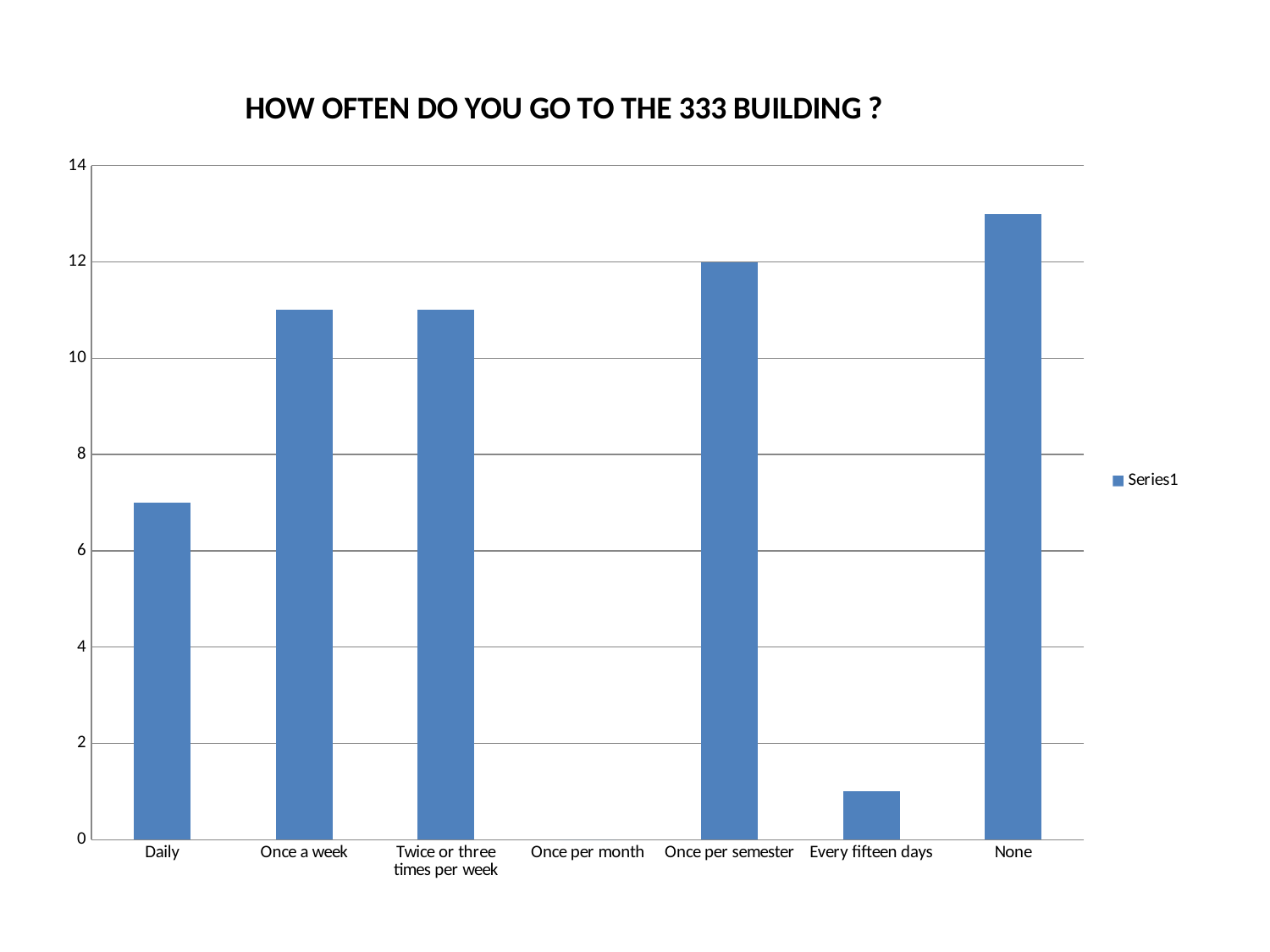
What is the value for Once per semester? 12 Which category has the highest value? None How many categories are shown on the x axis? 7 Is the value for Every fifteen days greater or less than 2? less Which category has the lowest value? Once per month Is the value for Daily greater or less than 6? greater What kind of chart is shown on the slide? bar chart What is the value for Once per month? 0 Which is larger, the value for Daily or the value for Once a week? Once a week How many series does the legend list? 1 What is the title of the chart? HOW OFTEN DO YOU GO TO THE 333 BUILDING ? Is the value for None greater or less than 12? greater